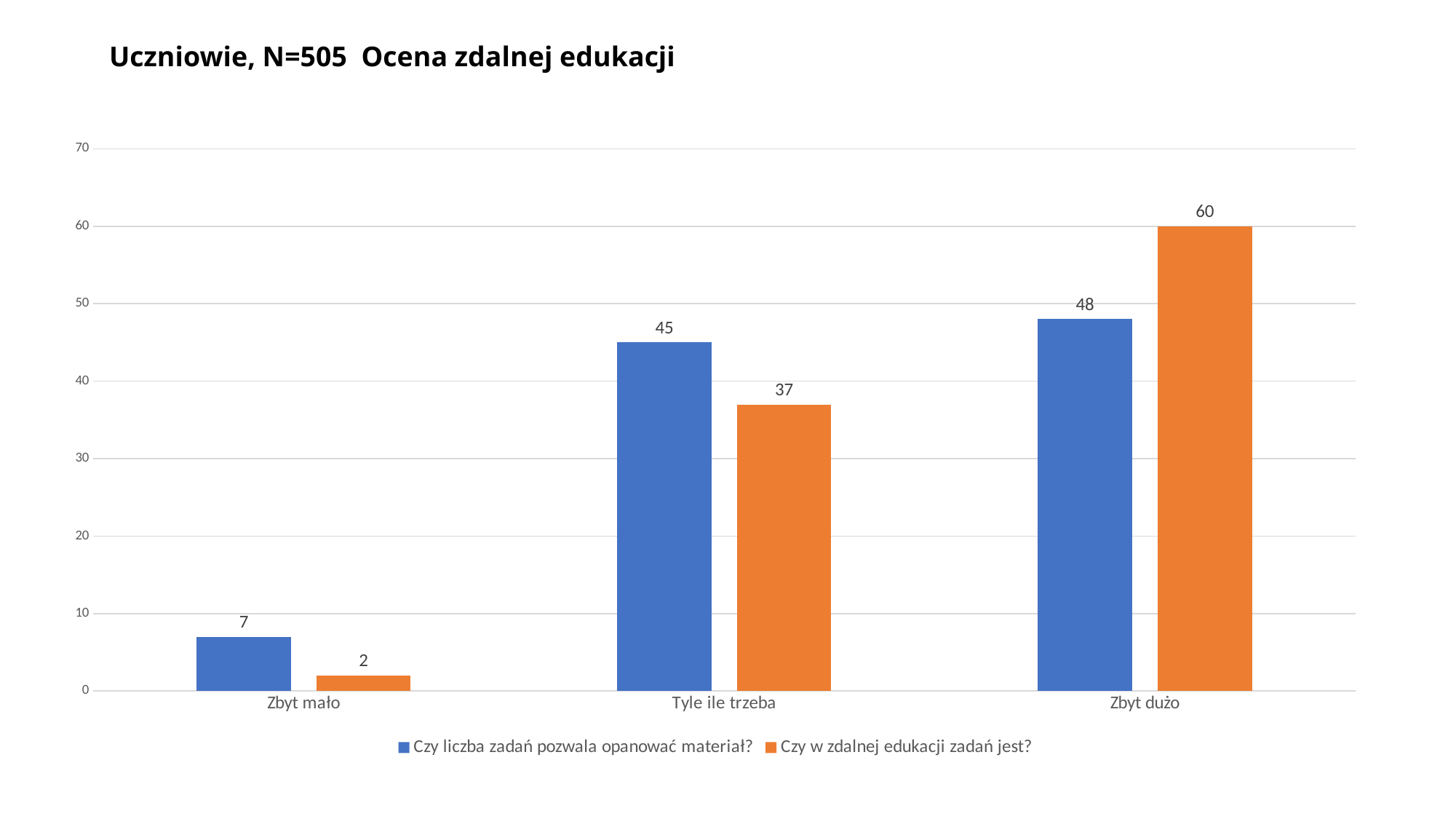
What is the value for "Zbyt mało" in the series "Czy liczba zadań pozwala opanować materiał?"? 7 Which category has the highest value in the series "Czy liczba zadań pozwala opanować materiał?"? Zbyt dużo How many series does the legend list? 2 What is the title of the chart? Uczniowie, N=505 Ocena zdalnej edukacji How many categories are shown on the x axis? 3 Which category has the lowest value in the series "Czy w zdalnej edukacji zadań jest?"? Zbyt mało For "Tyle ile trzeba", which series has the larger value? Czy liczba zadań pozwala opanować materiał? What is the difference between the two series' values for "Zbyt dużo"? 12 What is the value for "Tyle ile trzeba" in the series "Czy w zdalnej edukacji zadań jest?"? 37 Do the values in the series "Czy w zdalnej edukacji zadań jest?" rise or fall from left to right along the x axis? Rise What is the value for "Zbyt dużo" in the series "Czy w zdalnej edukacji zadań jest?"? 60 What kind of chart is shown on the slide? Bar chart